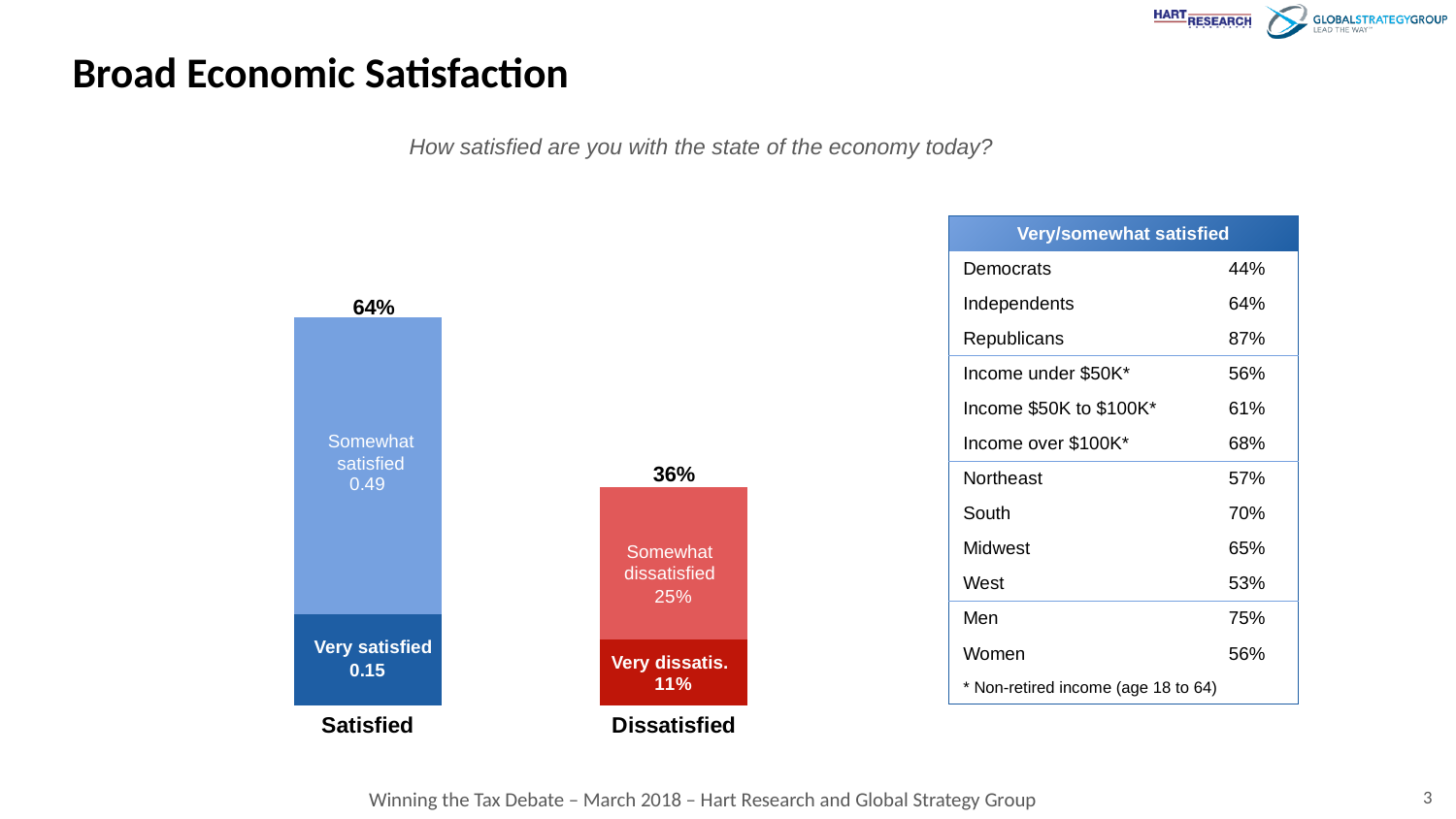
How many bars are plotted in the chart? 2 What is the difference between the Satisfied total and the Dissatisfied total? 28% What is the total shown above the Dissatisfied bar? 36% What survey question is shown above the chart? How satisfied are you with the state of the economy today? What is the total shown above the Satisfied bar? 64% Which bar is taller, Satisfied or Dissatisfied? Satisfied What value is printed for the Very dissatisfied segment? 11% What kind of chart is shown on the slide? stacked bar chart What value is printed for the Somewhat satisfied segment? 0.49 What value is printed for the Somewhat dissatisfied segment? 25% What value is printed for the Very satisfied segment? 0.15 What is the difference between the Somewhat dissatisfied and Very dissatisfied values? 14%